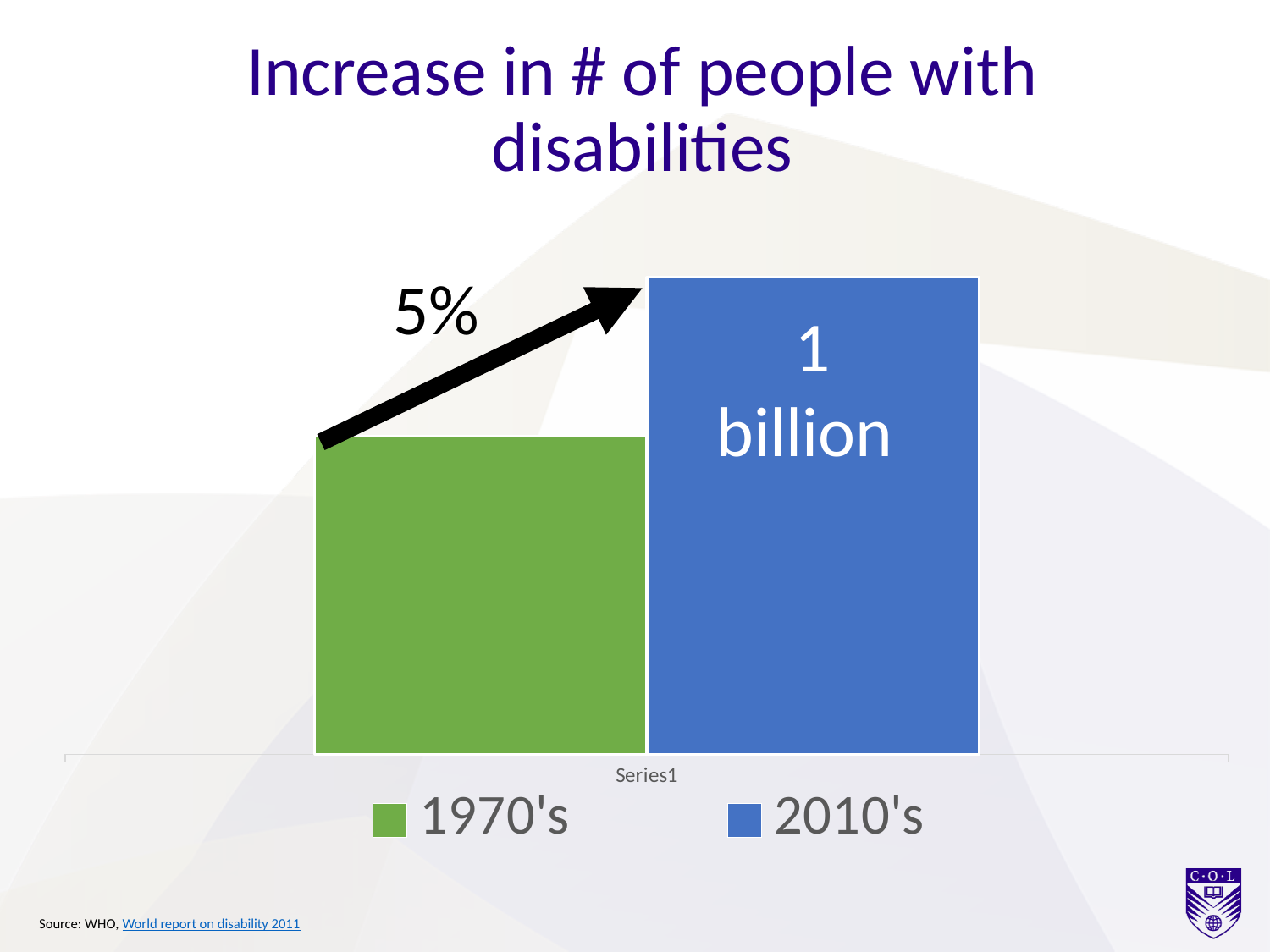
What colour is the bar for 1970's? green How many series does the legend list? 2 What is the title of the chart on the slide? Increase in # of people with disabilities How many bars are plotted in the chart? 2 What kind of chart is shown on the slide? bar chart Which series has the taller bar, 1970's or 2010's? 2010's What value is printed on the 2010's bar? 1 billion Is the bar for 2010's larger or smaller than the bar for 1970's? larger Do the bar values rise or fall from 1970's to 2010's? rise Which series has the shorter bar? 1970's